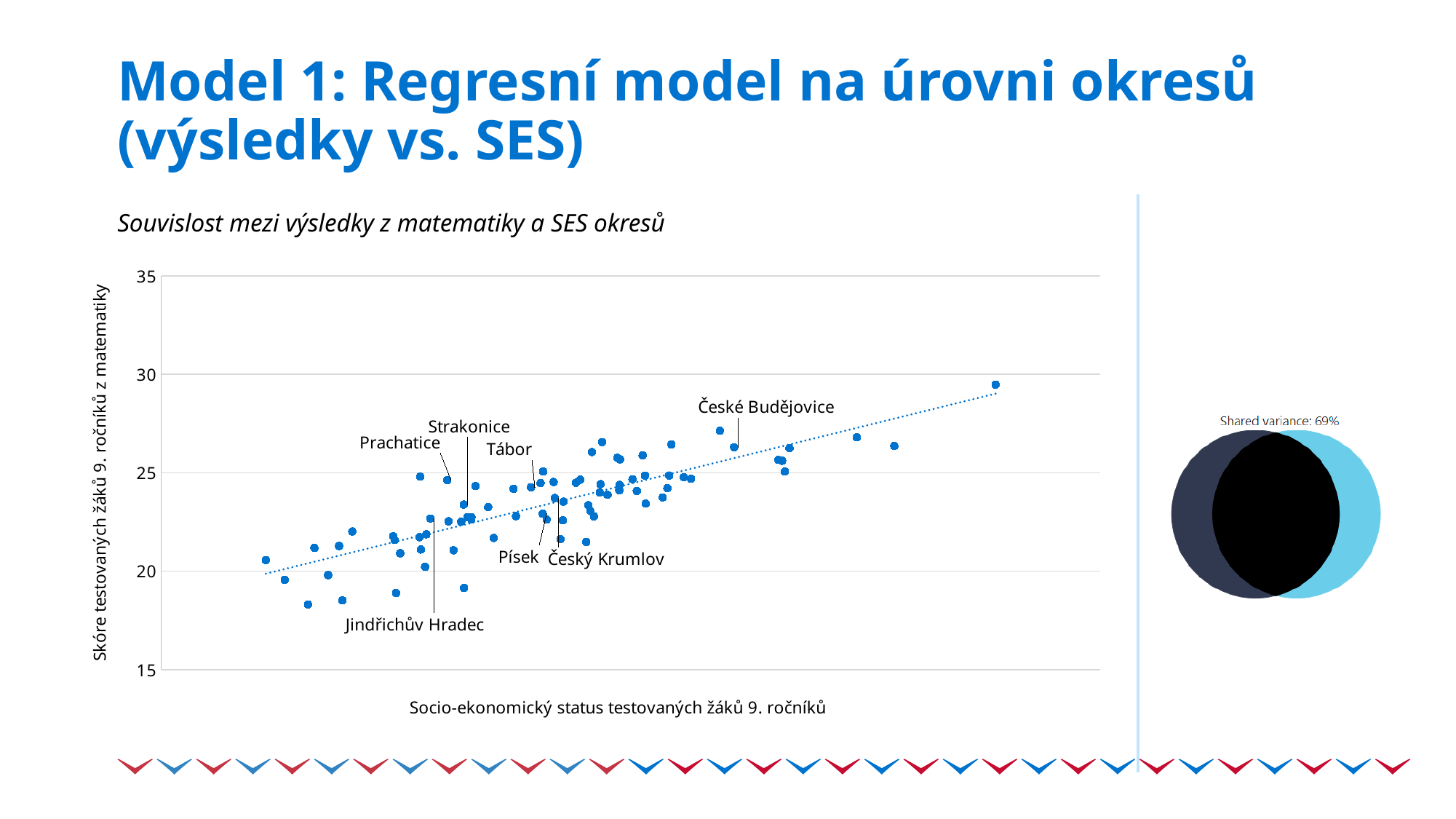
In the scatter plot, is the math score for Český Krumlov greater or less than 25? less What kind of chart is shown under the title 'Souvislost mezi výsledky z matematiky a SES okresů'? scatter plot In the scatter plot, which has the higher math score, České Budějovice or Jindřichův Hradec? České Budějovice In the scatter plot, is the math score for Jindřichův Hradec greater or less than 20? greater What is the label of the y axis of the scatter plot? Skóre testovaných žáků 9. ročníků z matematiky In the scatter plot, is the math score for Strakonice greater or less than 25? less In the scatter plot, which has the higher math score, Prachatice or Písek? Prachatice In the scatter plot, do the math scores generally rise or fall as socio-economic status increases along the x axis? rise What shared variance percentage is shown next to the Venn diagram on the right of the slide? 69%